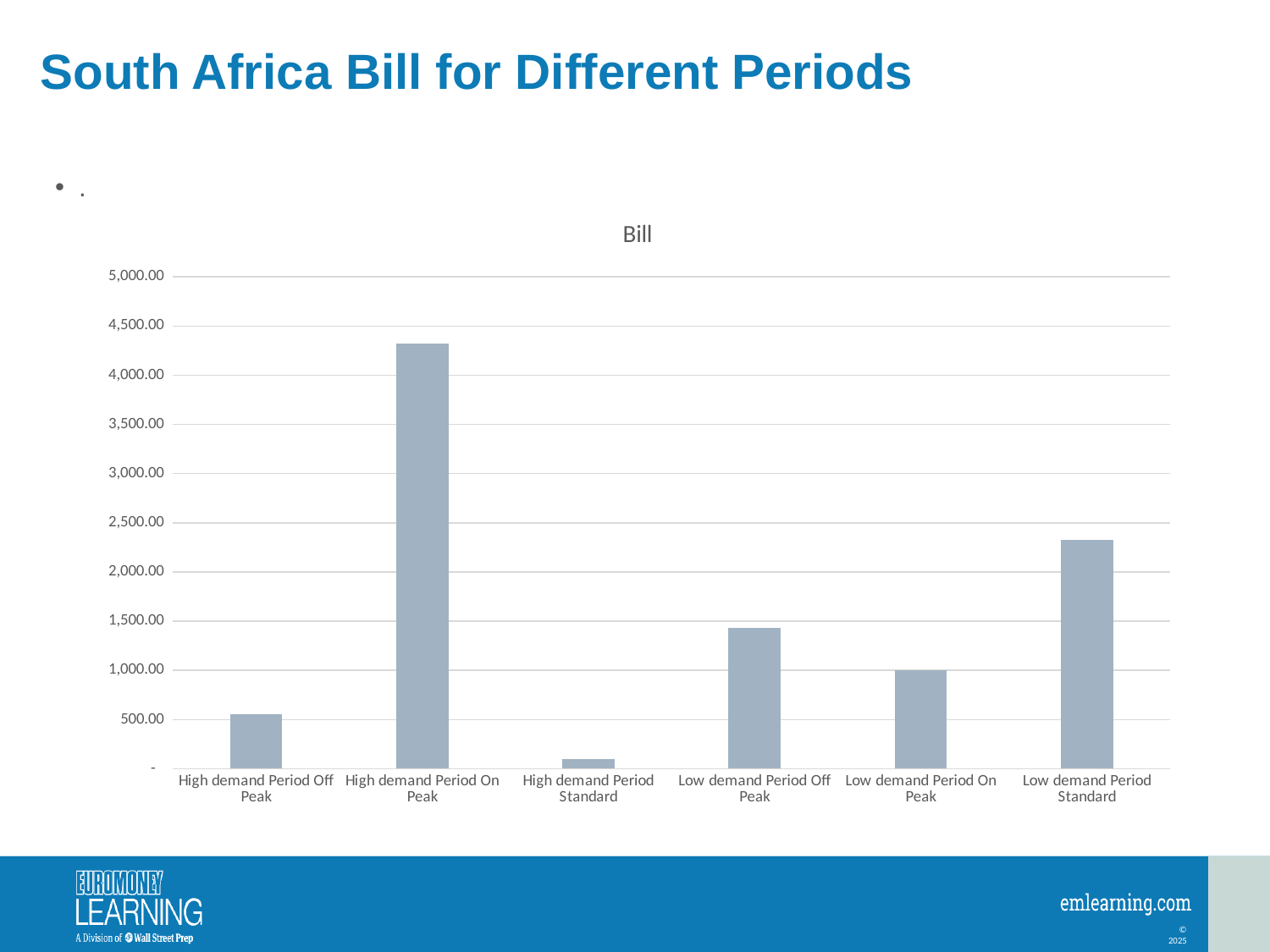
Is the value for Low demand Period Standard greater or less than 2,000.00? greater Is the value for High demand Period Standard greater or less than 500.00? less How many categories are plotted on the chart? 6 What is the title of the chart? Bill Is the value for Low demand Period Off Peak greater or less than 1,000.00? greater Which is larger, the bill for High demand Period Off Peak or the bill for Low demand Period On Peak? Low demand Period On Peak Which category has the highest bill? High demand Period On Peak Which category has the lowest bill? High demand Period Standard Which is larger, the bill for Low demand Period Standard or the bill for Low demand Period Off Peak? Low demand Period Standard What kind of chart is shown on the slide? bar chart